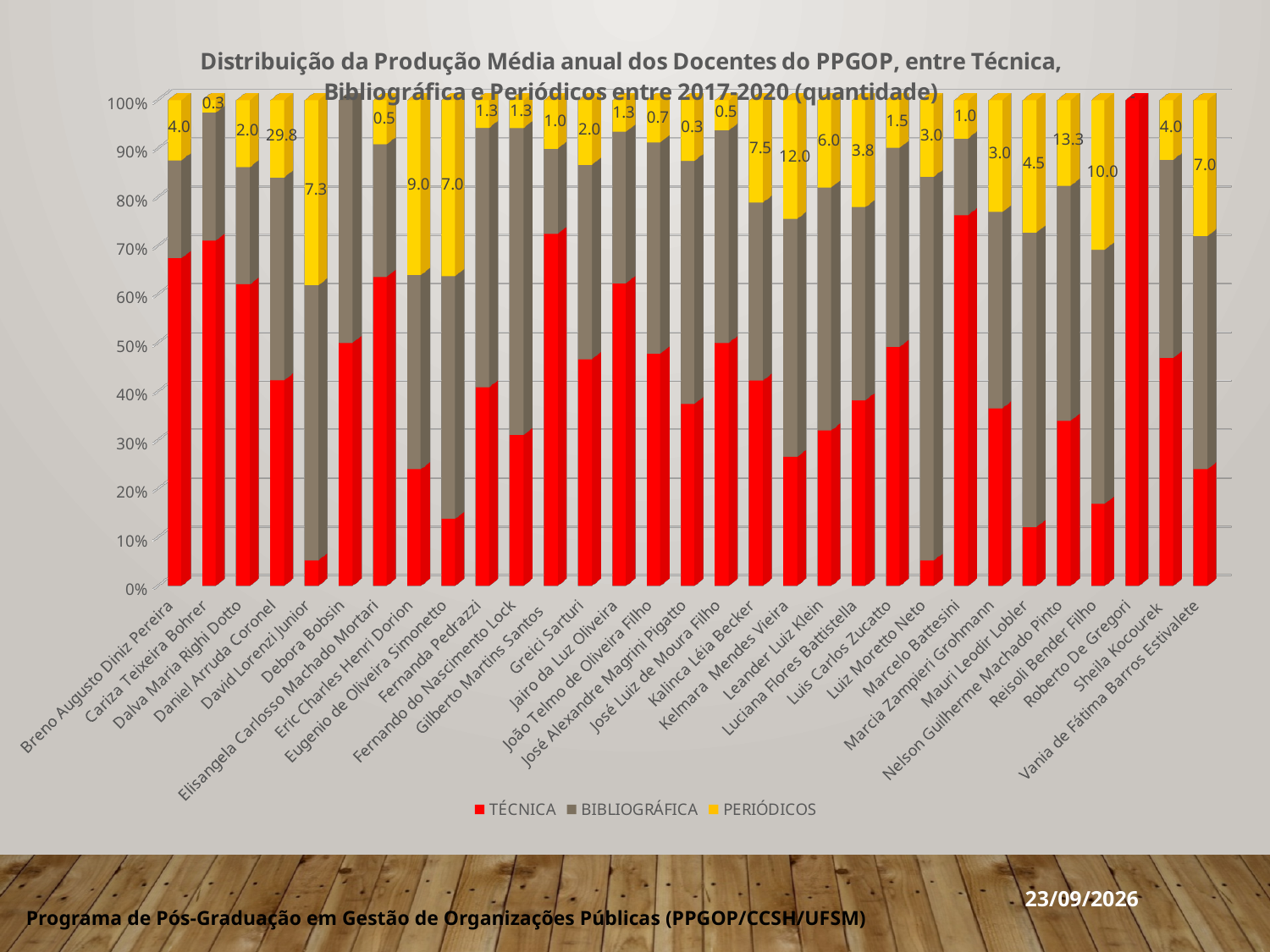
What is the PERIÓDICOS value shown for Daniel Arruda Coronel? 29.8 Is the TÉCNICA share of the bar for Breno Augusto Diniz Pereira greater or less than 60%? greater What is the PERIÓDICOS value shown for Eric Charles Henri Dorion? 9.0 What is the difference between the PERIÓDICOS values of Nelson Guilherme Machado Pinto and Reisoli Bender Filho? 3.3 Which series is shown in red in the legend? TÉCNICA Which has a larger PERIÓDICOS value, Kalinca Léia Becker or Leander Luiz Klein? Kalinca Léia Becker Which docente has the highest PERIÓDICOS data label? Daniel Arruda Coronel What kind of chart is shown on the slide? Stacked bar chart How many series does the legend list? 3 What is the PERIÓDICOS value shown for Kelmara Mendes Vieira? 12.0 What is the PERIÓDICOS value shown for Nelson Guilherme Machado Pinto? 13.3 Is the TÉCNICA share of the bar for Mauri Leodir Lobler greater or less than 20%? less